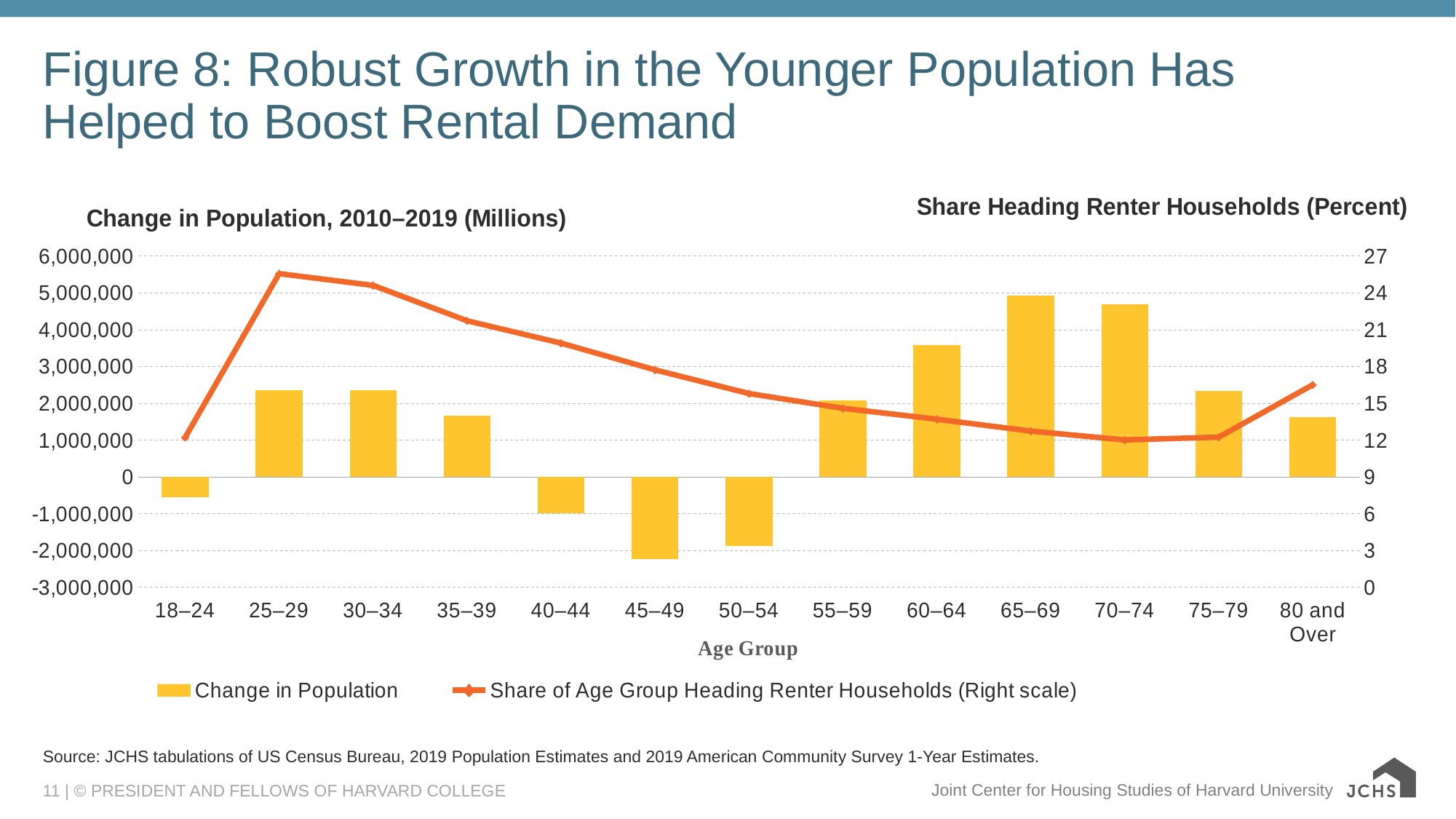
What kind of chart is shown on the slide? Combined bar and line chart Is the change in population for the 18–24 age group greater or less than 0? less Is the change in population for the 45–49 age group greater or less than -2,000,000? less Is the share heading renter households for the 18–24 age group greater or less than 15? less How many age groups are shown on the x axis? 13 How many series does the legend list? 2 Does the share heading renter households rise or fall from the 25–29 age group to the 70–74 age group? fall Which age group has the lowest (most negative) change in population? 45–49 Which age group has the highest share heading renter households? 25–29 Which age group has the larger share heading renter households, 30–34 or 55–59? 30–34 Which age group has the larger change in population, 35–39 or 60–64? 60–64